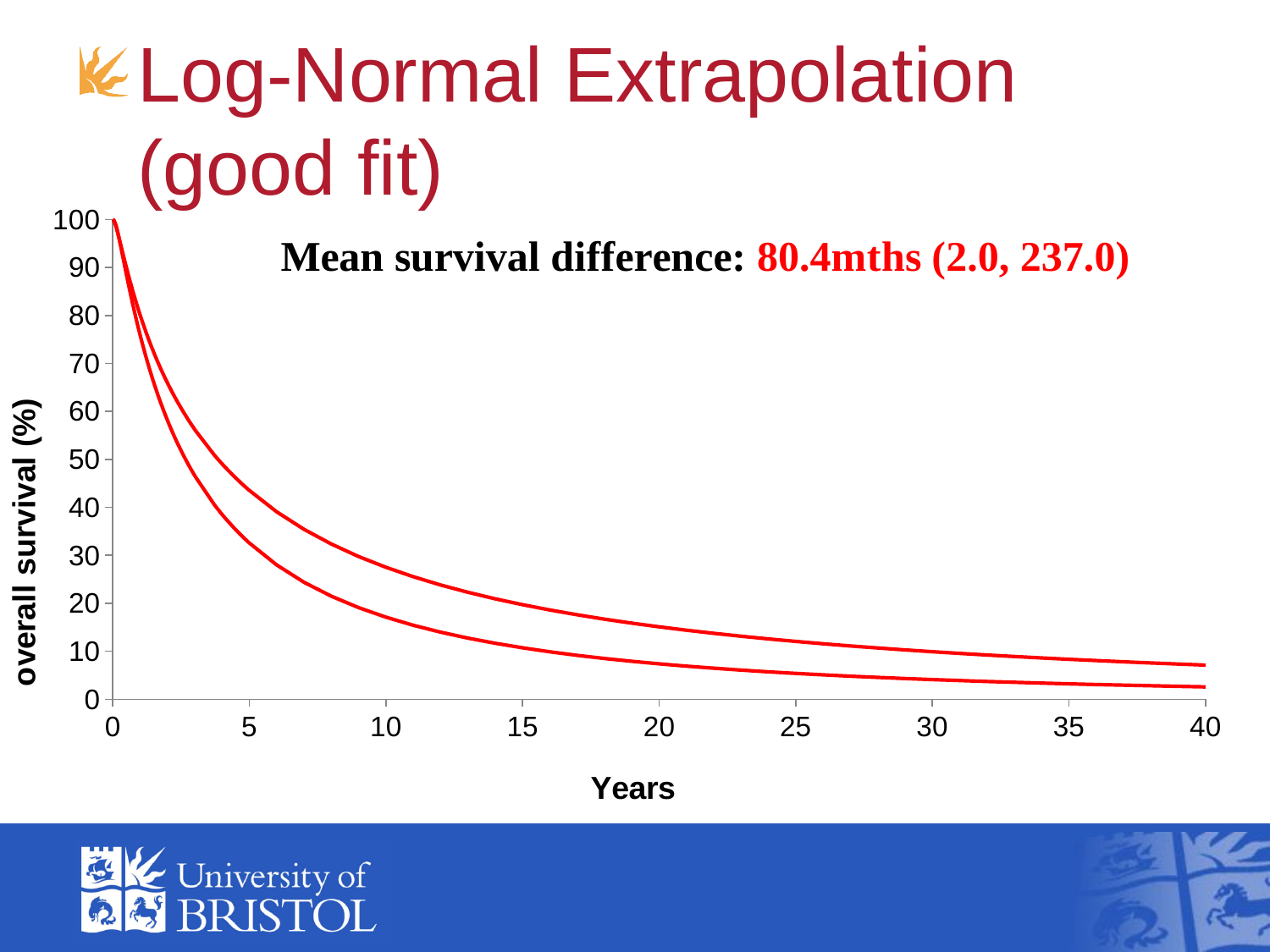
What mean survival difference is stated on the chart? 80.4mths (2.0, 237.0) At year 20, is the value of the upper curve greater or less than 10? greater At year 5, which curve has the higher overall survival, the upper curve or the lower curve? the upper curve What is the label of the y axis? overall survival (%) At year 10, is the value of the lower curve greater or less than 10? greater What is the overall survival (%) value of both curves at year 0? 100 How many curves are plotted on the chart? 2 What kind of chart is shown on the slide? line chart Do the survival curves rise or fall as the years increase along the x axis? fall At year 40, is the value of the upper curve greater or less than 10? less